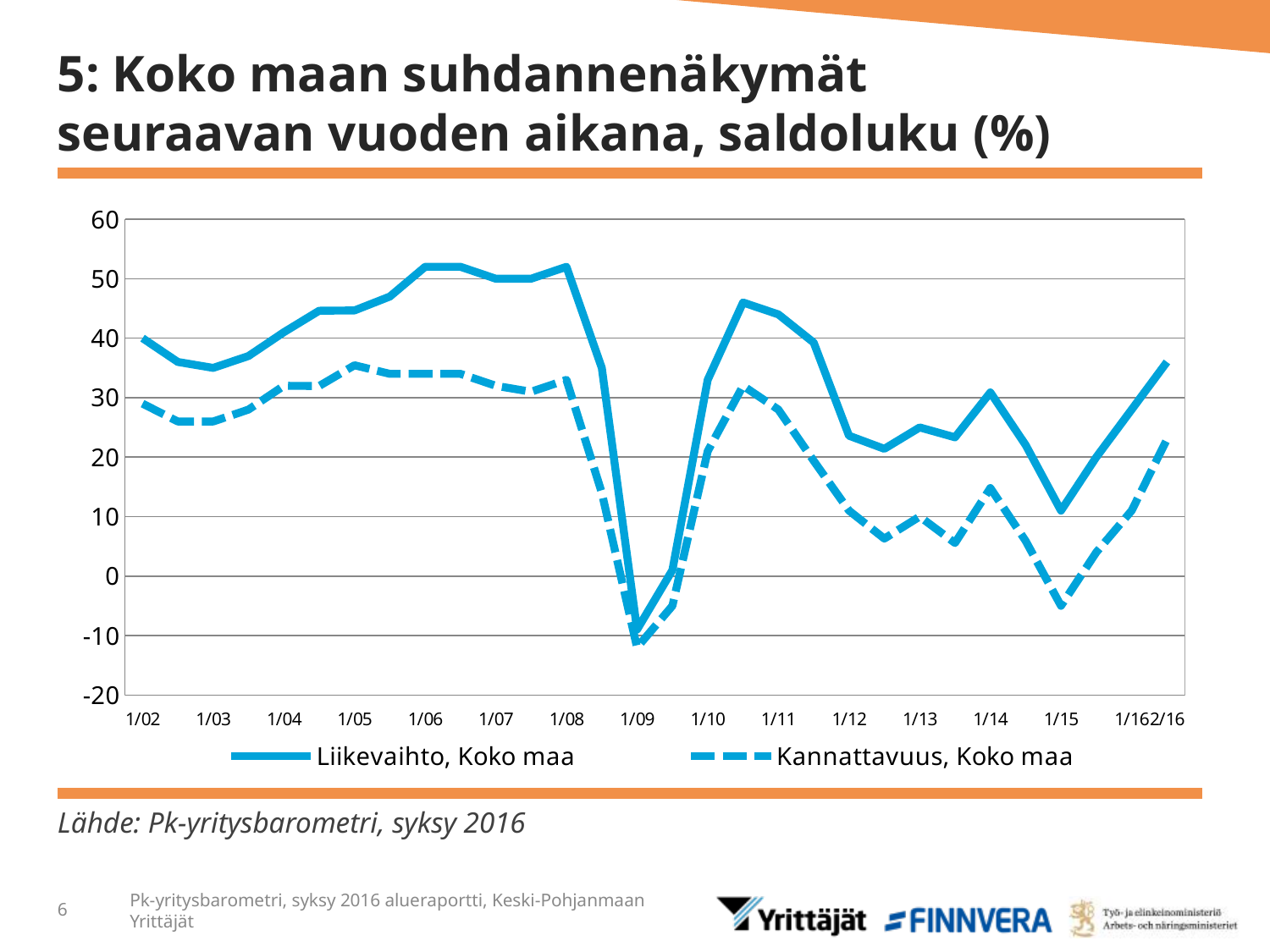
At 1/08, which series has the larger value, Liikevaihto, Koko maa or Kannattavuus, Koko maa? Liikevaihto, Koko maa Is the value for Liikevaihto, Koko maa at 1/06 greater or less than 50? greater Is the value for Liikevaihto, Koko maa at 1/12 greater or less than 20? greater What are the two series named in the legend? Liikevaihto, Koko maa and Kannattavuus, Koko maa At which x-axis label does the Liikevaihto, Koko maa series reach its lowest value? 1/09 Is the value for Liikevaihto, Koko maa at 1/09 greater or less than 0? less What kind of chart is shown on the slide? line chart Between 1/15 and 2/16, does the Liikevaihto, Koko maa series rise or fall? rise Which series is drawn with a dashed line? Kannattavuus, Koko maa At which x-axis label does the Kannattavuus, Koko maa series reach its lowest value? 1/09 How many series does the legend list? 2